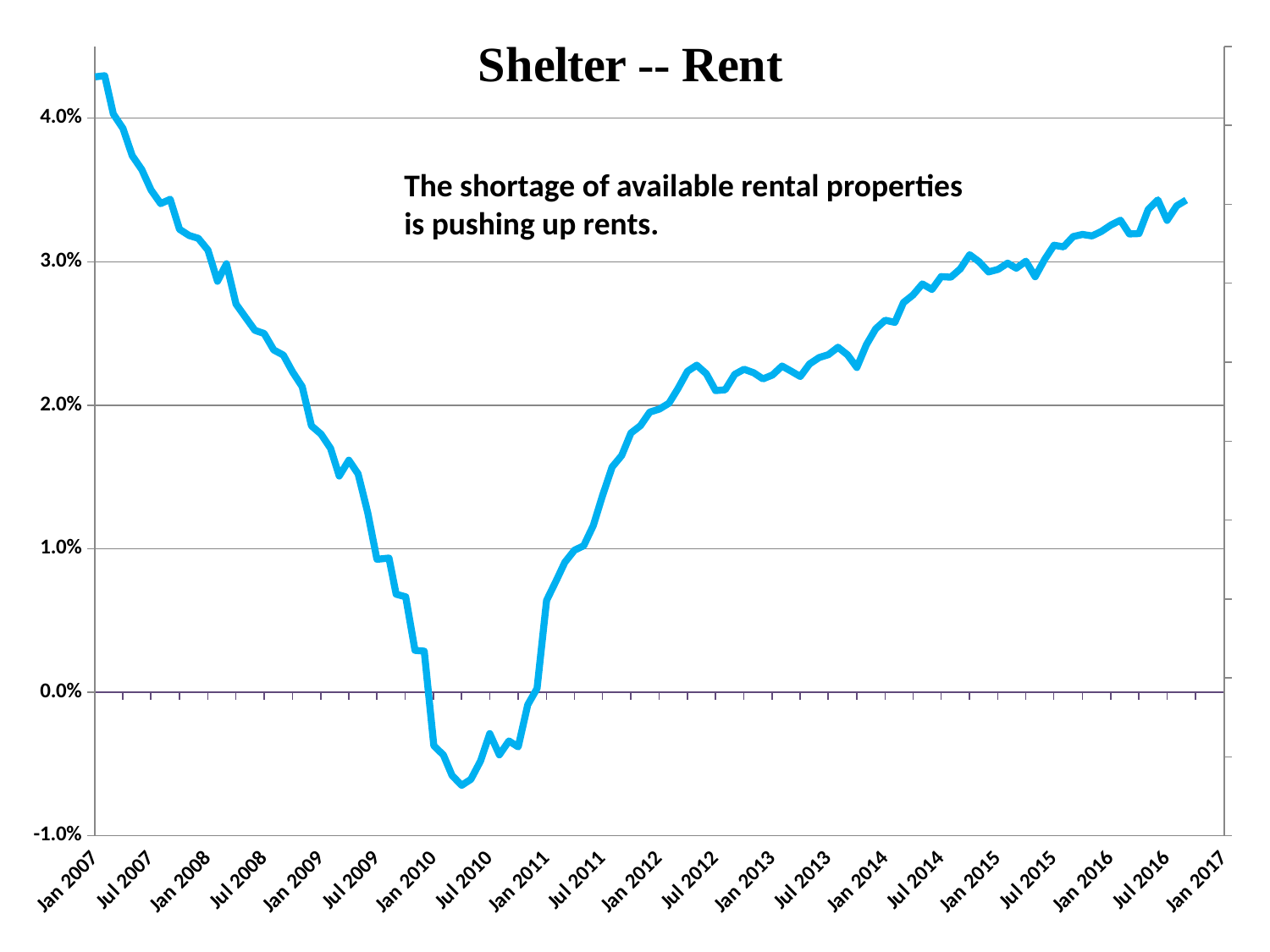
Is the value at Jan 2007 greater or less than 4.0%? greater Does the line rise or fall between Jan 2007 and Jan 2010? fall What kind of chart is shown on the slide? line chart Is the value at Jan 2014 greater or less than 2.0%? greater What is the title of the chart? Shelter -- Rent Does the line rise or fall between Jul 2010 and Jul 2016? rise Is the value at Jul 2010 greater or less than 0.0%? less At which x-axis date does the line reach its highest value? Jan 2007 What does the annotation text on the chart say? The shortage of available rental properties is pushing up rents.